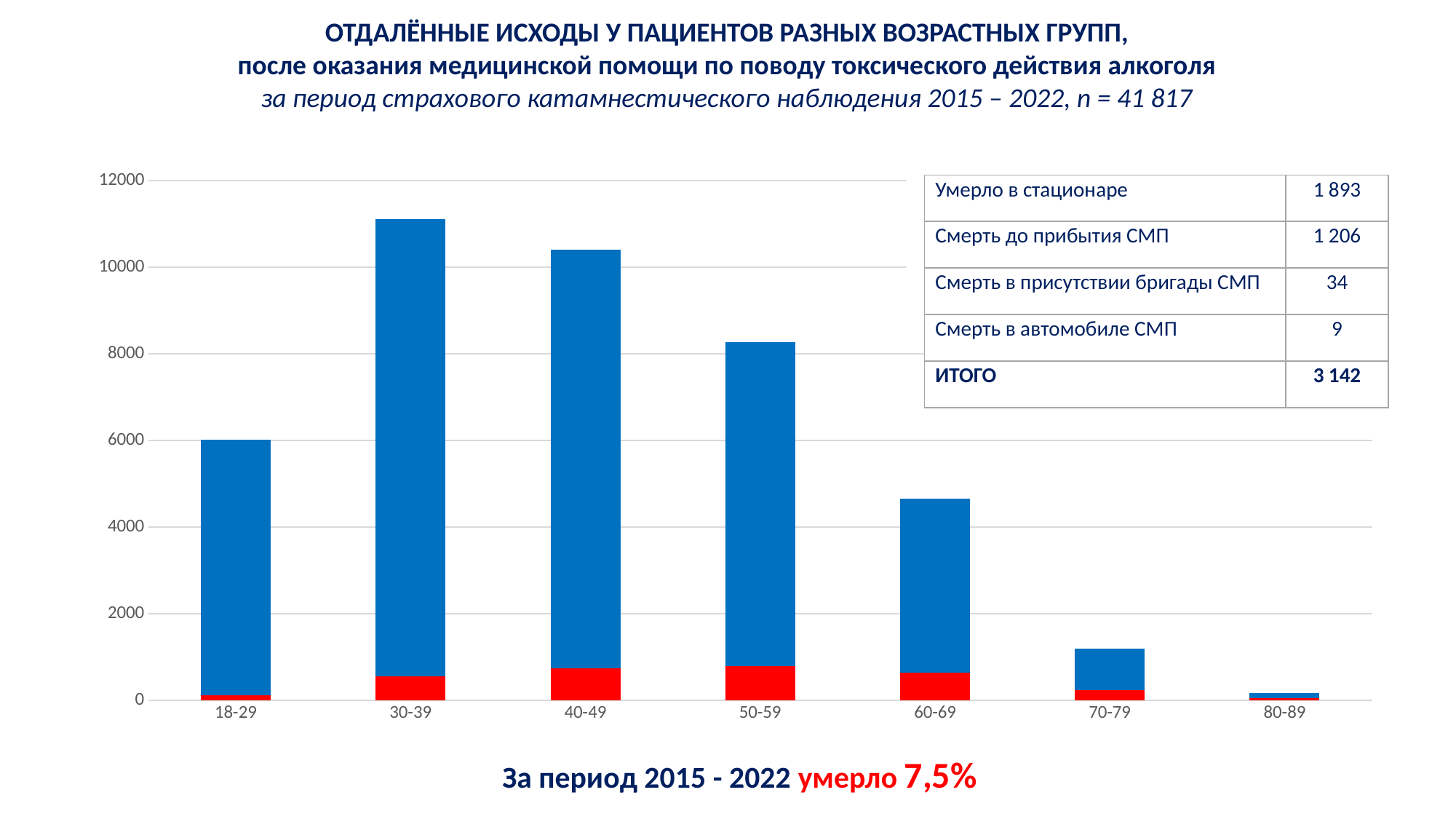
What kind of chart is shown on the slide? bar chart Which age group has the tallest bar in the chart? 30-39 Which bar is taller, 40-49 or 50-59? 40-49 Is the total value for the 18-29 bar greater or less than 4000? greater Which bar is taller, 18-29 or 60-69? 18-29 Which age group has the shortest bar in the chart? 80-89 How many age groups are shown on the x axis of the chart? 7 What colour is the lower segment of each stacked bar? red Do the bar heights rise or fall from the 30-39 group to the 80-89 group? fall Is the total value for the 60-69 bar greater or less than 6000? less Is the total value for the 70-79 bar greater or less than 2000? less